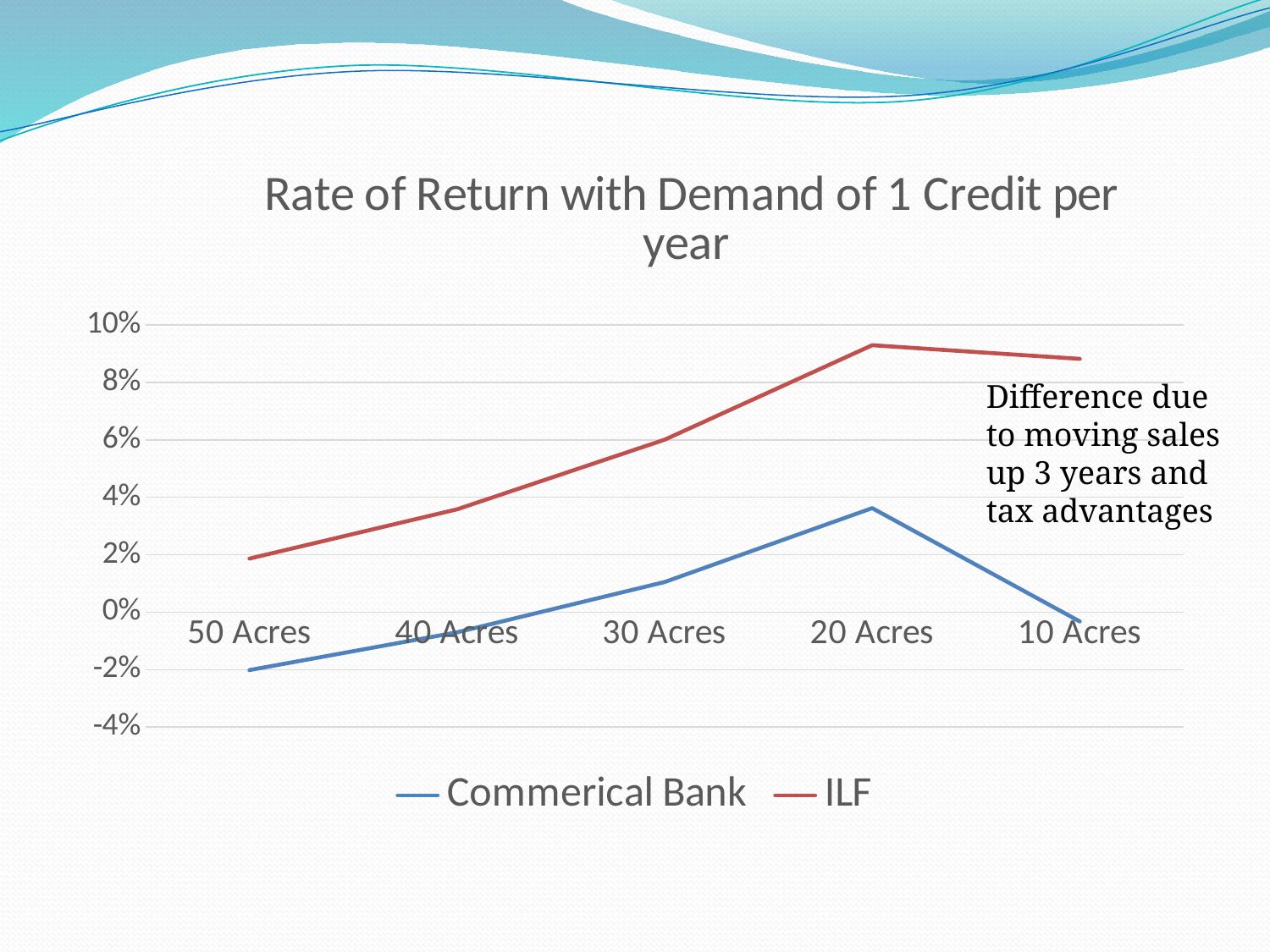
At which acreage does the ILF line reach its highest value? 20 Acres Is the ILF value at 20 Acres greater or less than 8%? greater What kind of chart is shown on the slide? line chart At which acreage is the Commerical Bank line at its lowest value? 50 Acres What is the title of the chart? Rate of Return with Demand of 1 Credit per year Is the ILF value at 50 Acres greater or less than 4%? less Is the Commerical Bank value at 40 Acres greater or less than 0%? less How many categories are shown on the x axis? 5 At 30 Acres, which series has the higher rate of return, Commerical Bank or ILF? ILF At which acreage does the Commerical Bank line reach its highest value? 20 Acres Does the Commerical Bank line rise or fall from 50 Acres to 20 Acres? rise How many series does the legend list? 2